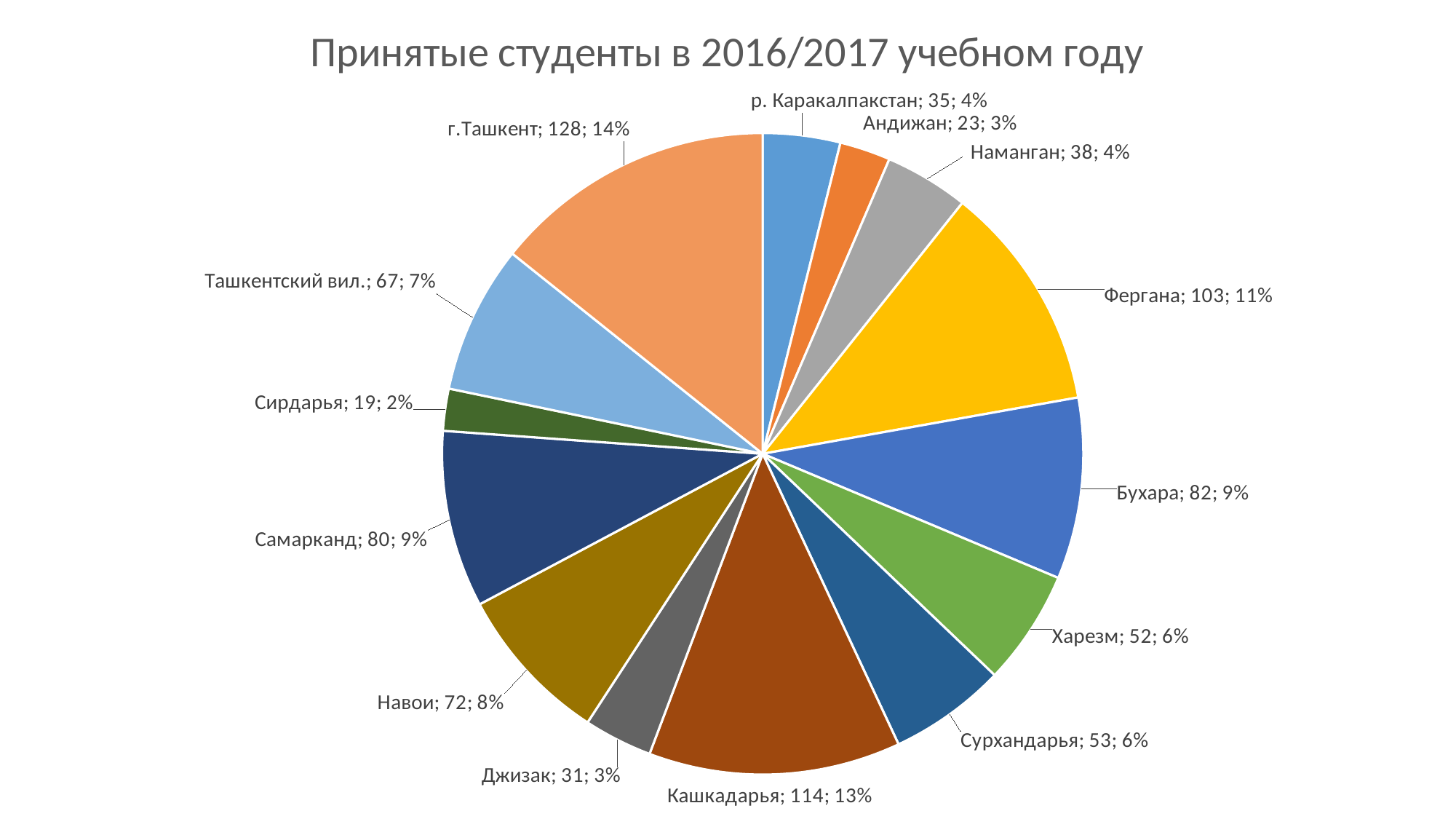
What is the difference between the number of students from г.Ташкент and from Кашкадарья? 14 What is the title of the chart? Принятые студенты в 2016/2017 учебном году What share of the pie does г.Ташкент represent? 14% How many students were admitted from Фергана? 103 How many slices (regions) does the pie chart have? 14 How many students were admitted from Кашкадарья? 114 Which has more admitted students, Фергана or Бухара? Фергана What share of the pie does Сирдарья represent? 2% Which region has the largest number of admitted students? г.Ташкент What is the difference between the number of students from Самарканд and from Навои? 8 Which region has the smallest number of admitted students? Сирдарья What kind of chart is shown on the slide? Pie chart